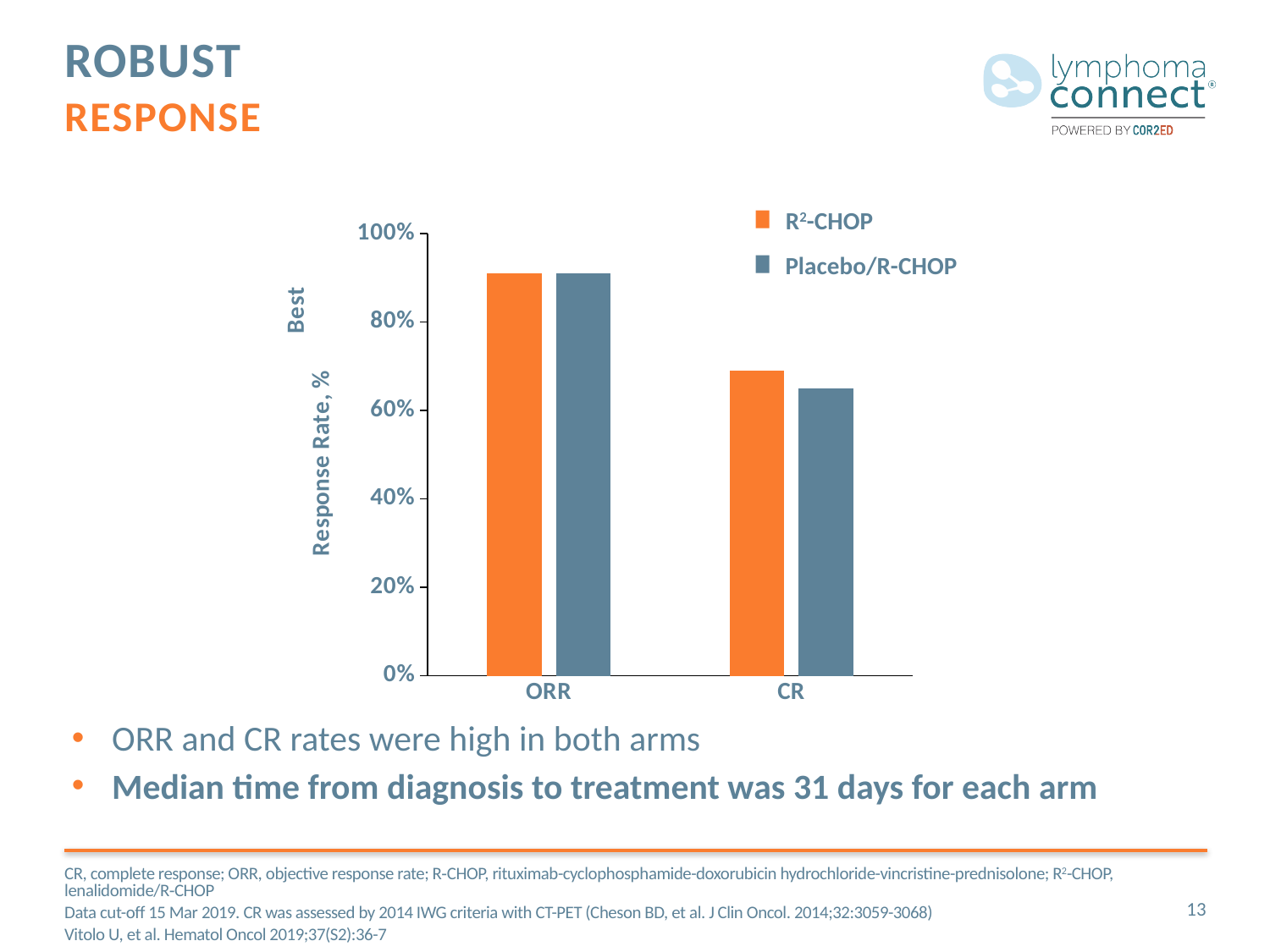
How many series does the legend list? 2 Which series is shown in orange? R2-CHOP What kind of chart is shown on the slide? bar chart What is the y-axis label of the chart? Best Response Rate, % Is the CR value for R2-CHOP greater or less than 60%? greater For the R2-CHOP series, do the values rise or fall from ORR to CR? fall Is the CR value for Placebo/R-CHOP greater or less than 80%? less For CR, which arm has the higher value, R2-CHOP or Placebo/R-CHOP? R2-CHOP How many categories are shown on the x axis? 2 Is the ORR value for Placebo/R-CHOP greater or less than 80%? greater